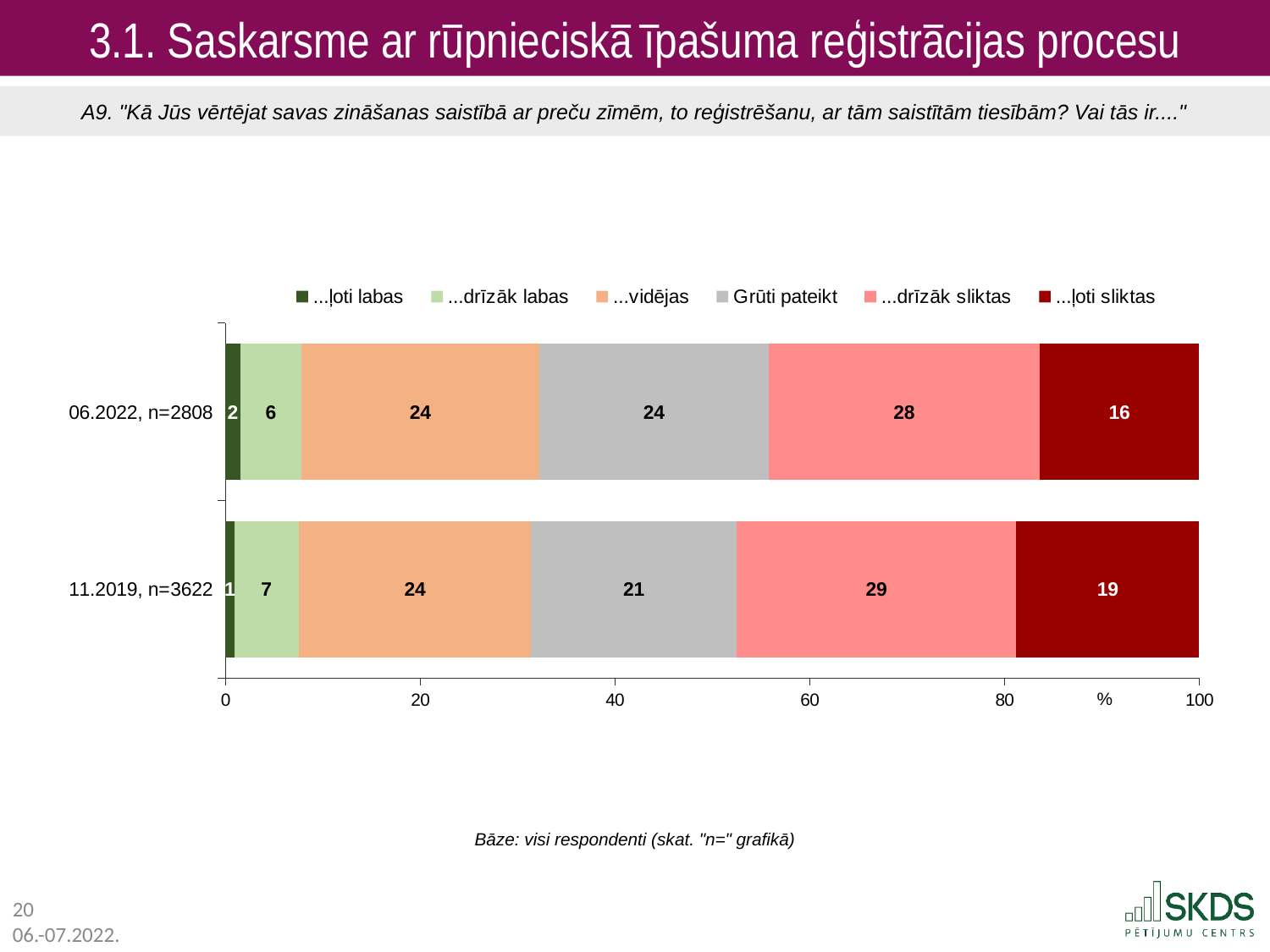
What is the difference between the "...ļoti sliktas" values for 11.2019, n=3622 and 06.2022, n=2808? 3 What kind of chart is shown on the slide? stacked bar chart Which series has the smallest value in the 11.2019, n=3622 bar? ...ļoti labas How many categories (bars) are plotted in the chart? 2 What is the value for "Grūti pateikt" in the 06.2022, n=2808 bar? 24 What is the total of the 06.2022, n=2808 stacked bar? 100 Which bar has the larger value for "Grūti pateikt": 06.2022, n=2808 or 11.2019, n=3622? 06.2022, n=2808 Which series has the largest value in the 06.2022, n=2808 bar? ...drīzāk sliktas What is the value for "...ļoti sliktas" in the 11.2019, n=3622 bar? 19 What is the value for "...drīzāk sliktas" in the 06.2022, n=2808 bar? 28 How many series does the legend list? 6 What is the value for "...drīzāk labas" in the 11.2019, n=3622 bar? 7